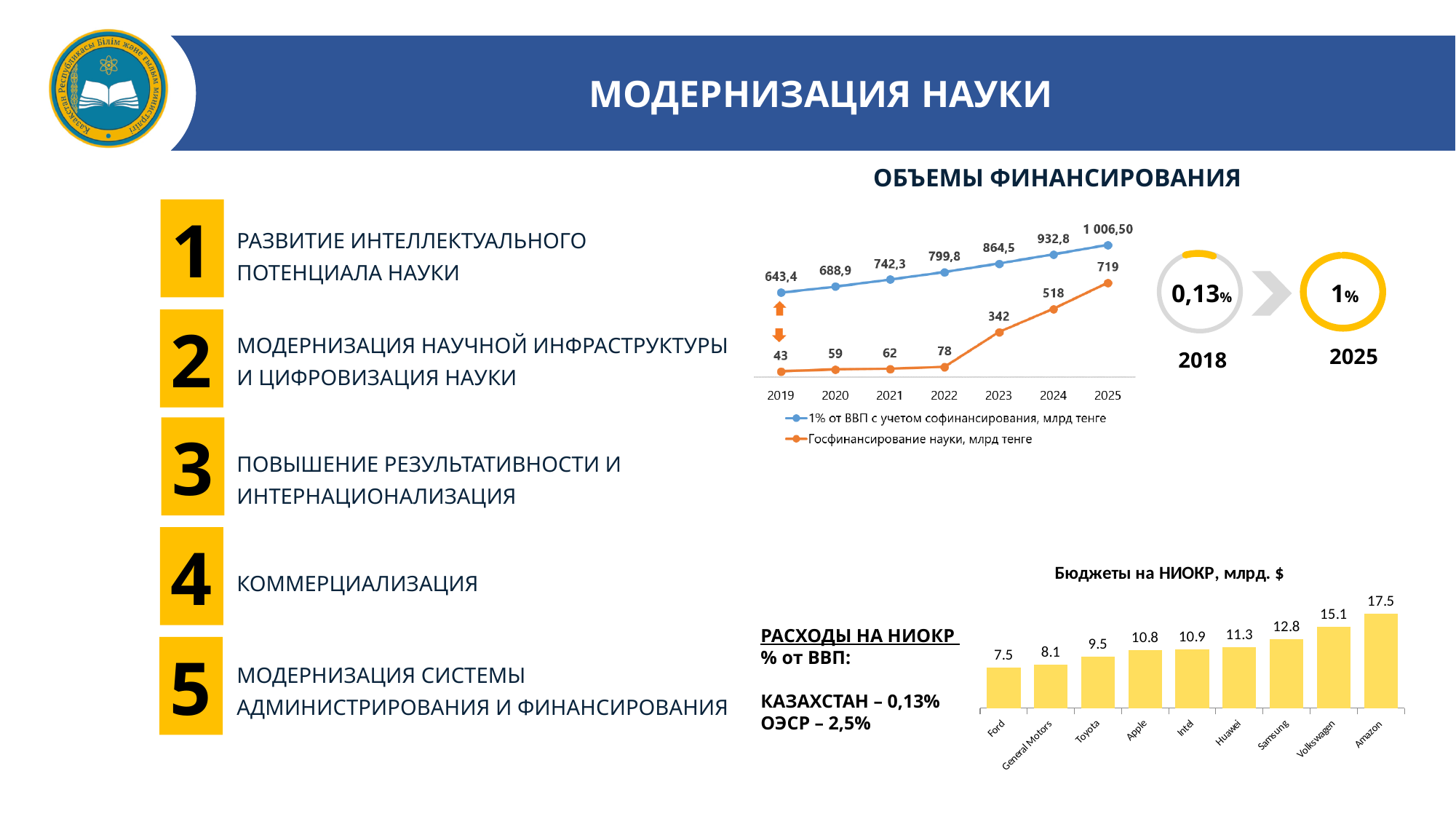
In the chart titled "ОБЪЕМЫ ФИНАНСИРОВАНИЯ", how many years are shown on the x axis? 7 In the chart titled "ОБЪЕМЫ ФИНАНСИРОВАНИЯ", does the "Госфинансирование науки, млрд тенге" series rise or fall from 2019 to 2025? Rise In the chart titled "ОБЪЕМЫ ФИНАНСИРОВАНИЯ", how many series does the legend list? 2 In the chart titled "ОБЪЕМЫ ФИНАНСИРОВАНИЯ", what is the value of "Госфинансирование науки, млрд тенге" for 2023? 342 In the chart titled "Бюджеты на НИОКР, млрд. $", what is the value for Samsung? 12.8 In the chart titled "Бюджеты на НИОКР, млрд. $", which company has the lowest value? Ford In the chart titled "ОБЪЕМЫ ФИНАНСИРОВАНИЯ", what is the difference between the 2025 and 2024 values of "Госфинансирование науки, млрд тенге"? 201 In the chart titled "ОБЪЕМЫ ФИНАНСИРОВАНИЯ", what type of chart is used? Line chart In the chart titled "Бюджеты на НИОКР, млрд. $", how many companies are shown? 9 In the chart titled "Бюджеты на НИОКР, млрд. $", what is the difference between the values for Volkswagen and Toyota? 5.6 In the chart titled "ОБЪЕМЫ ФИНАНСИРОВАНИЯ", what is the value of "1% от ВВП с учетом софинансирования, млрд тенге" for 2025? 1 006,50 In the chart titled "Бюджеты на НИОКР, млрд. $", which company has the highest value? Amazon